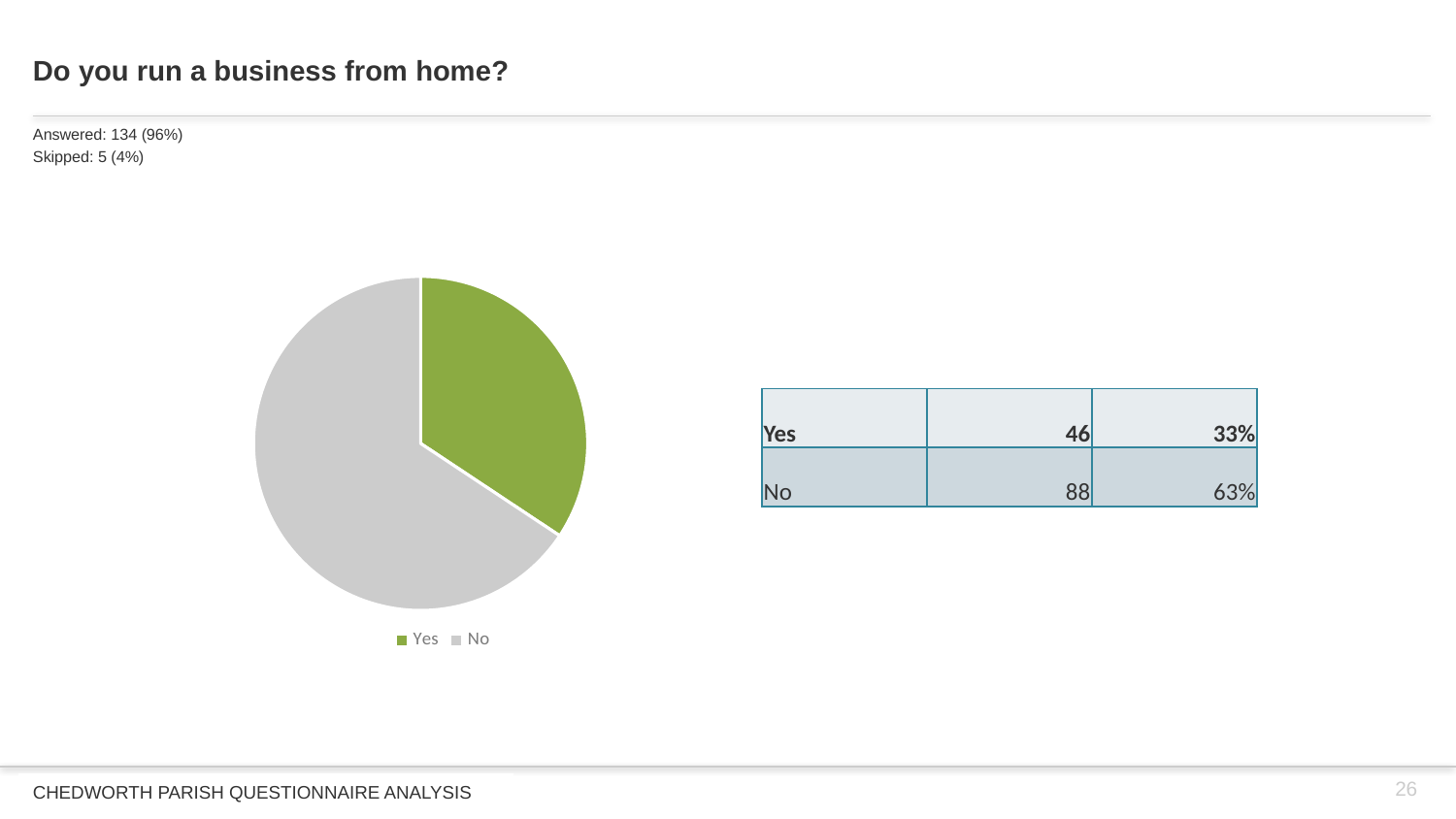
According to the table next to the pie chart, how many respondents answered Yes? 46 Which response has the smallest slice in the pie chart? Yes What colour is the Yes slice in the pie chart? green Which response has the largest slice in the pie chart? No According to the table next to the pie chart, how many respondents answered No? 88 What kind of chart is shown on the slide? pie chart What is the difference between the number of No and Yes responses shown in the table? 42 How many slices does the pie chart have? 2 What share of the pie does the Yes slice represent, according to the table? 33% Which response has the larger slice in the pie chart, Yes or No? No How many entries does the legend of the pie chart list? 2 What share of the pie does the No slice represent, according to the table? 63%